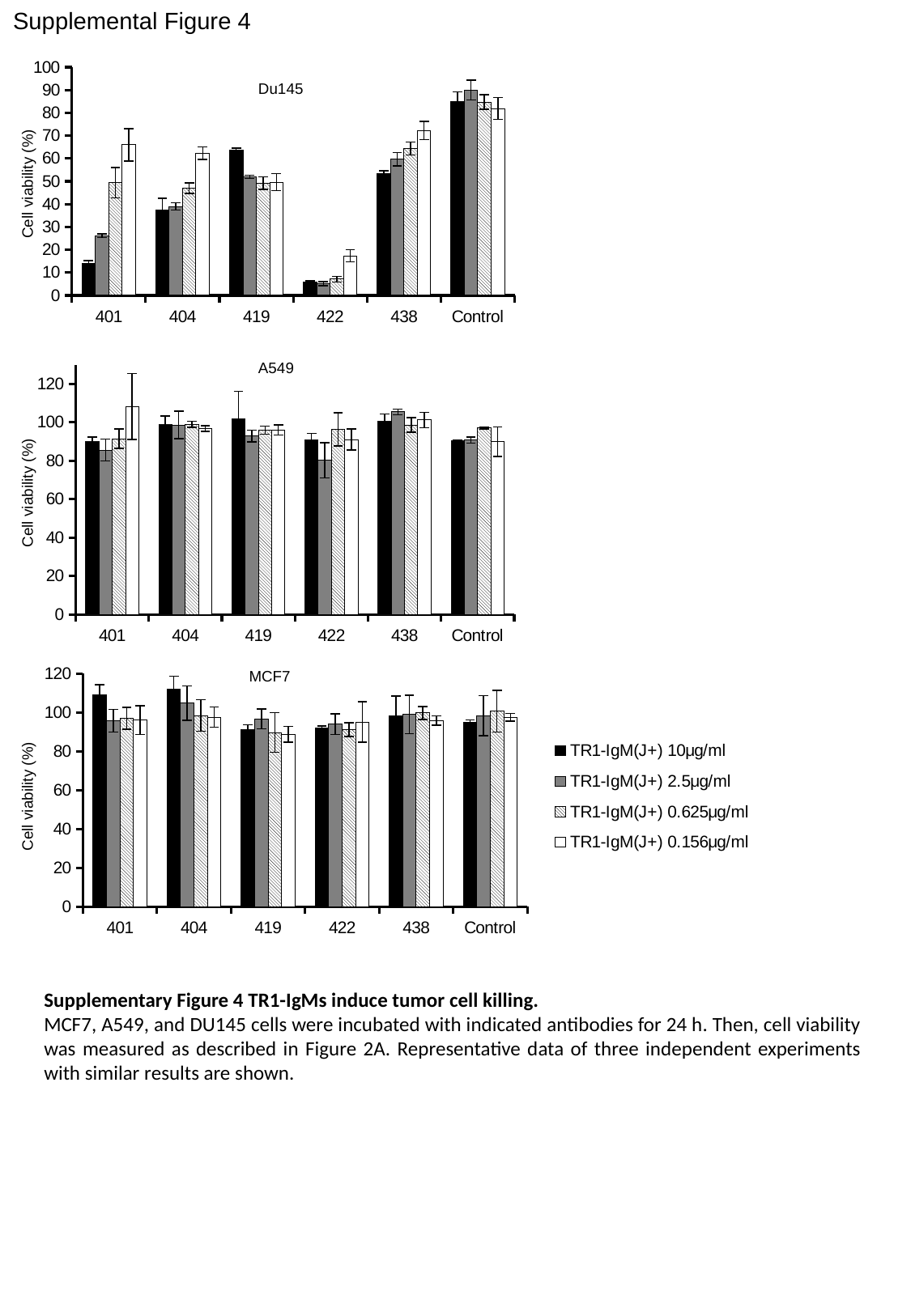
In the MCF7 chart, is the value for TR1-IgM(J+) 10µg/ml at 404 greater or less than 100? greater What is the y-axis label of the MCF7 chart? Cell viability (%) How many categories are shown on the x axis of the A549 chart? 6 In the Du145 chart, is the value for TR1-IgM(J+) 0.156µg/ml at 422 greater or less than 20? less In the Du145 chart, is the value for TR1-IgM(J+) 10µg/ml at 419 greater or less than 60? greater In the Du145 chart, which is larger for TR1-IgM(J+) 10µg/ml: 419 or 401? 419 In the Du145 chart, which category has the highest value for TR1-IgM(J+) 10µg/ml? Control In the Du145 chart, which category has the lowest value for TR1-IgM(J+) 10µg/ml? 422 How many series does the legend list? 4 What kind of chart is the Du145 chart? bar chart